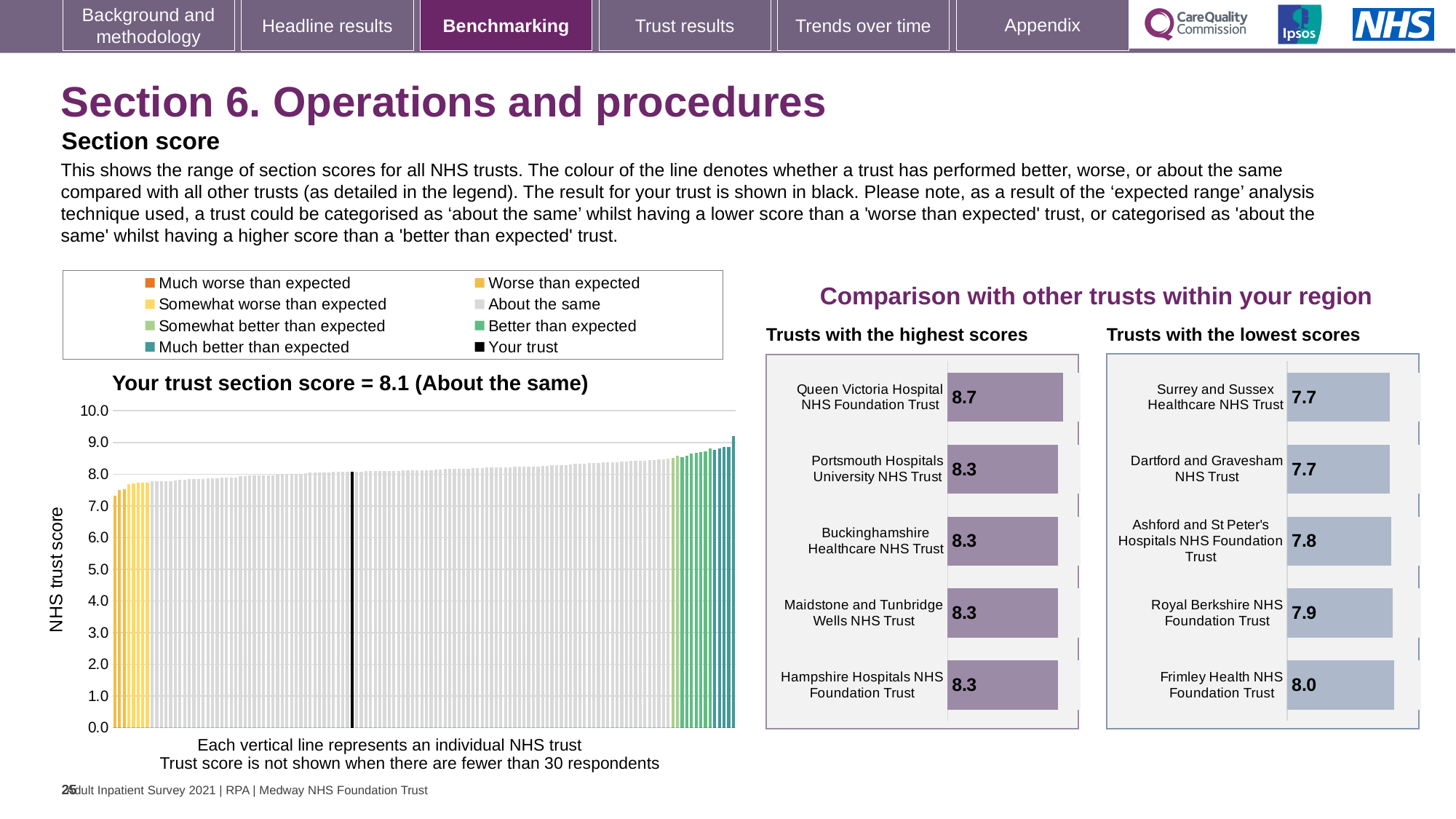
In the 'Trusts with the lowest scores' chart, what is the score for Royal Berkshire NHS Foundation Trust? 7.9 How many trusts are shown in the 'Trusts with the highest scores' chart? 5 In the 'Trusts with the lowest scores' chart, which trust has the highest score? Frimley Health NHS Foundation Trust What kind of chart is the left-hand chart showing the range of section scores for all NHS trusts? bar chart In the 'Trusts with the lowest scores' chart, which has the larger score: Royal Berkshire NHS Foundation Trust or Ashford and St Peter's Hospitals NHS Foundation Trust? Royal Berkshire NHS Foundation Trust In the left-hand chart of all NHS trusts, do the scores rise or fall from left to right along the x axis? rise In the 'Trusts with the highest scores' chart, what is the difference between the scores of Queen Victoria Hospital NHS Foundation Trust and Portsmouth Hospitals University NHS Trust? 0.4 In the 'Trusts with the highest scores' chart, what is the score for Queen Victoria Hospital NHS Foundation Trust? 8.7 What is the section score for your trust shown in the title of the left-hand chart? 8.1 In the 'Trusts with the lowest scores' chart, what is the difference between the scores of Frimley Health NHS Foundation Trust and Surrey and Sussex Healthcare NHS Trust? 0.3 How many entries does the legend above the left-hand chart list? 8 In the 'Trusts with the highest scores' chart, which trust has the highest score? Queen Victoria Hospital NHS Foundation Trust